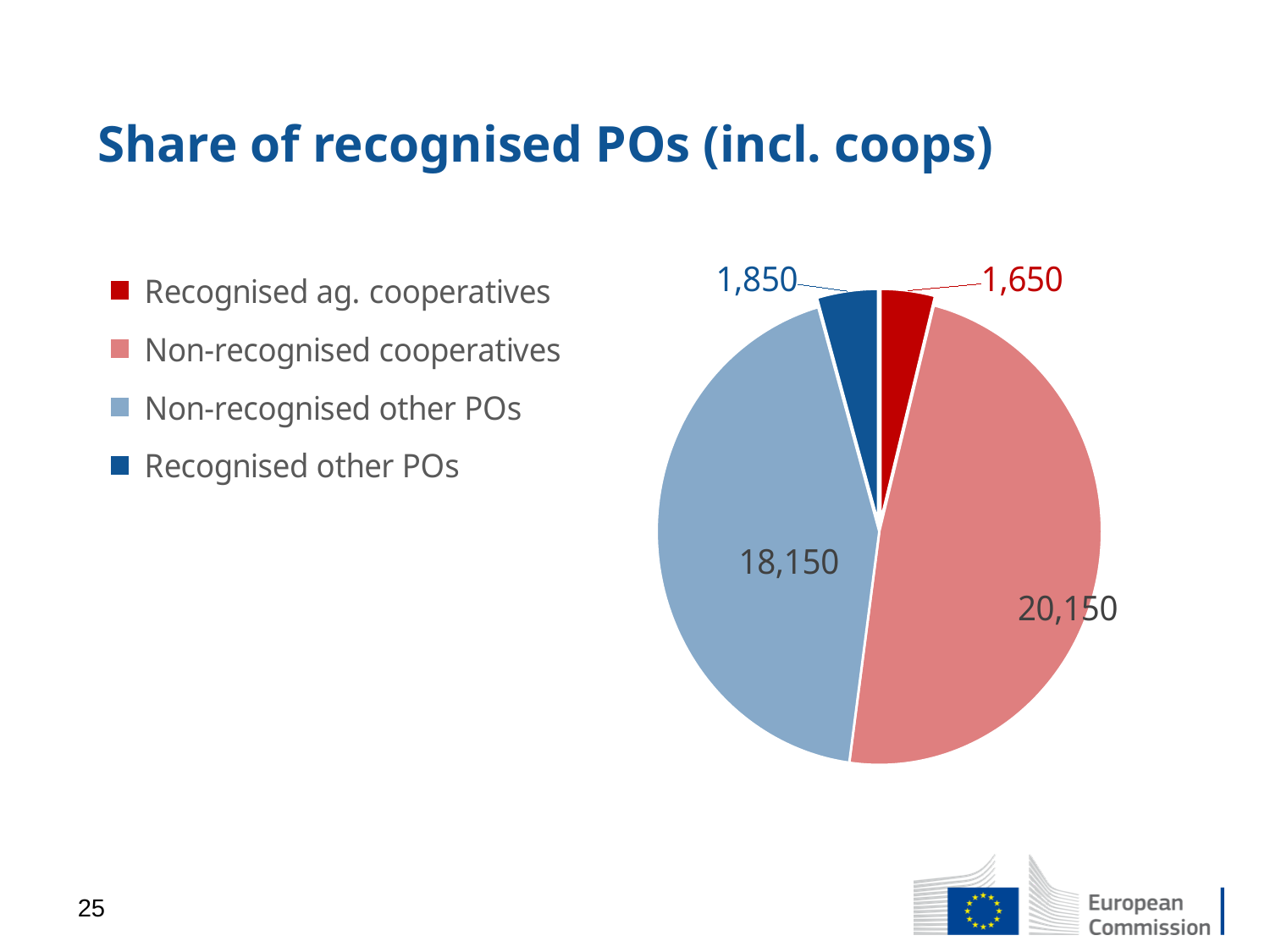
Which category has the smallest slice of the pie? Recognised ag. cooperatives What value is shown for Non-recognised other POs? 18,150 How many categories does the pie chart show? 4 What kind of chart is shown on the slide? Pie chart What value is shown for Non-recognised cooperatives? 20,150 What is the difference between the values for Recognised other POs and Recognised ag. cooperatives? 200 What value is shown for Recognised other POs? 1,850 What colour is the slice for Recognised ag. cooperatives? Red Which category has the largest slice of the pie? Non-recognised cooperatives What is the difference between the values for Non-recognised cooperatives and Non-recognised other POs? 2,000 What value is shown for Recognised ag. cooperatives? 1,650 Which is larger, the value for Recognised other POs or the value for Recognised ag. cooperatives? Recognised other POs